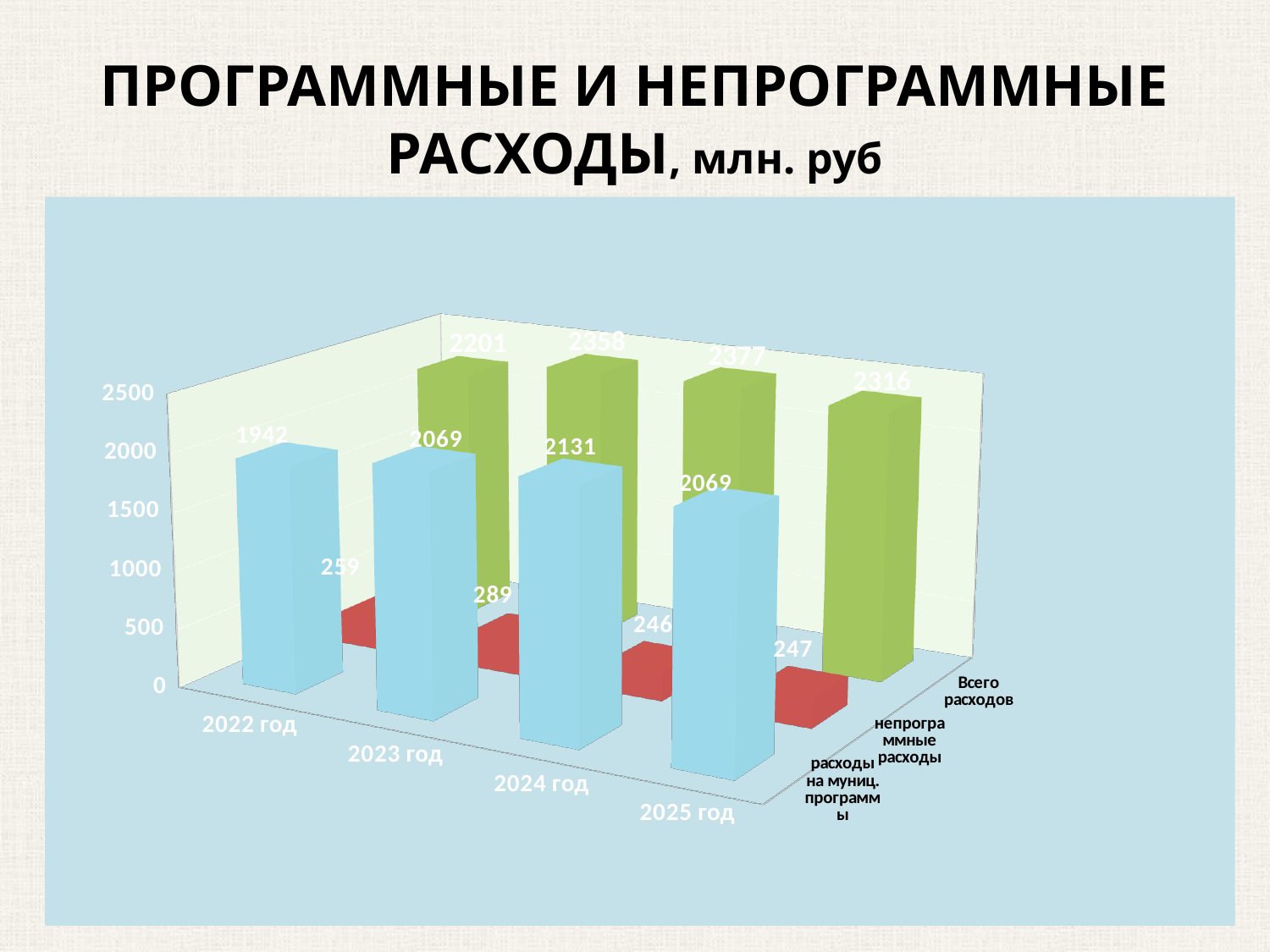
What is the value for Всего расходов in 2025 год? 2316 What is the difference between Всего расходов in 2023 год and in 2022 год? 157 What unit is given in the chart title? млн. руб Which is larger: расходы на муниц. программы in 2024 год or in 2023 год? 2024 год What is the value for расходы на муниц. программы in 2022 год? 1942 In which year is непрограммные расходы the lowest? 2024 год What is the value for расходы на муниц. программы in 2024 год? 2131 What kind of chart is shown on the slide? bar chart In which year is Всего расходов the highest? 2024 год How many years are shown on the chart? 4 What is the value for непрограммные расходы in 2023 год? 289 How many series does the chart show? 3